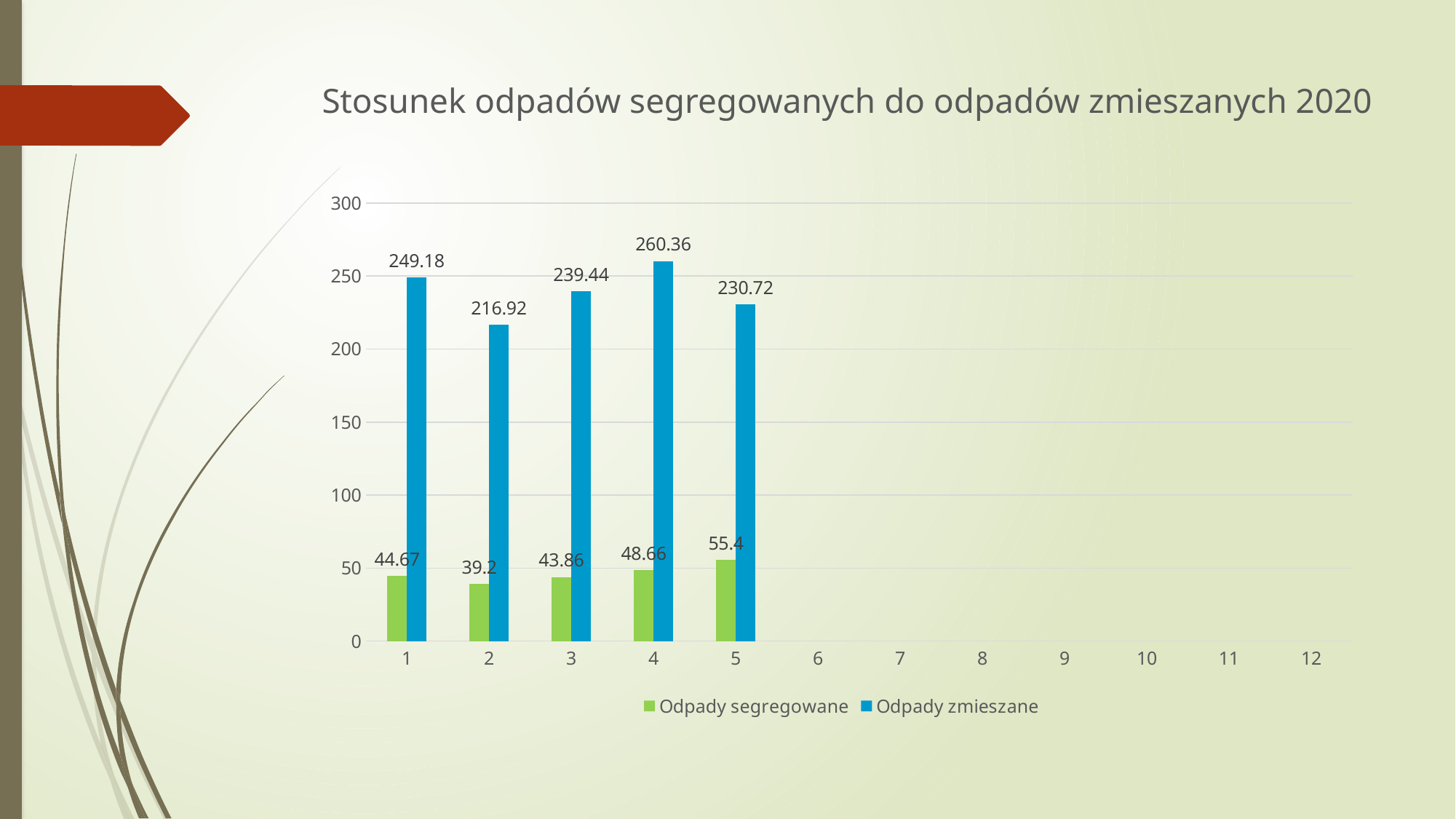
What is the difference between the Odpady zmieszane values for category 1 and category 2? 32.26 What is the value of Odpady zmieszane for category 5? 230.72 Which category has the highest value for Odpady segregowane? 5 How many series does the legend list? 2 Is the value of Odpady zmieszane for category 2 greater or less than 200? greater What is the value of Odpady segregowane for category 2? 39.2 What is the value of Odpady zmieszane for category 4? 260.36 What is the difference between Odpady zmieszane and Odpady segregowane for category 4? 211.7 How many categories have bars plotted on the chart? 5 Which is larger: Odpady zmieszane for category 3 or for category 5? Category 3 What type of chart is shown on the slide? Bar chart Which category has the lowest value for Odpady zmieszane? 2